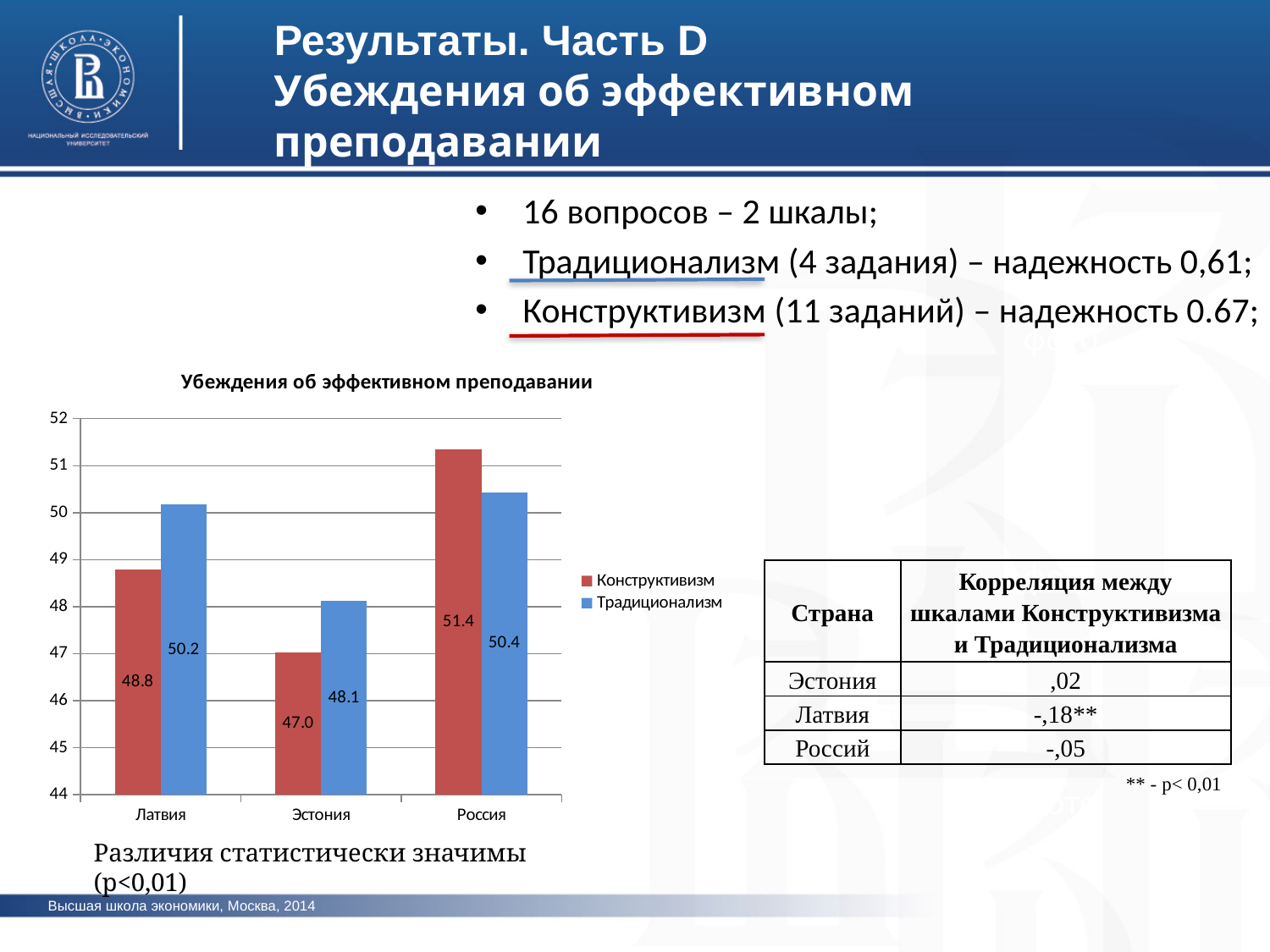
How many series does the chart legend list? 2 Is the value for Конструктивизм in Эстония greater or less than 48? less What is the value for Конструктивизм in Латвия? 48.8 What is the value for Традиционализм in Россия? 50.4 Which country has the lowest value for Традиционализм? Эстония What is the value for Традиционализм in Эстония? 48.1 What is the difference between Традиционализм and Конструктивизм in Латвия? 1.4 Which country has the highest value for Конструктивизм? Россия What type of chart is shown on the slide? bar chart How many countries are shown on the x axis of the chart? 3 What is the value for Конструктивизм in Россия? 51.4 In Россия, which is larger: Конструктивизм or Традиционализм? Конструктивизм